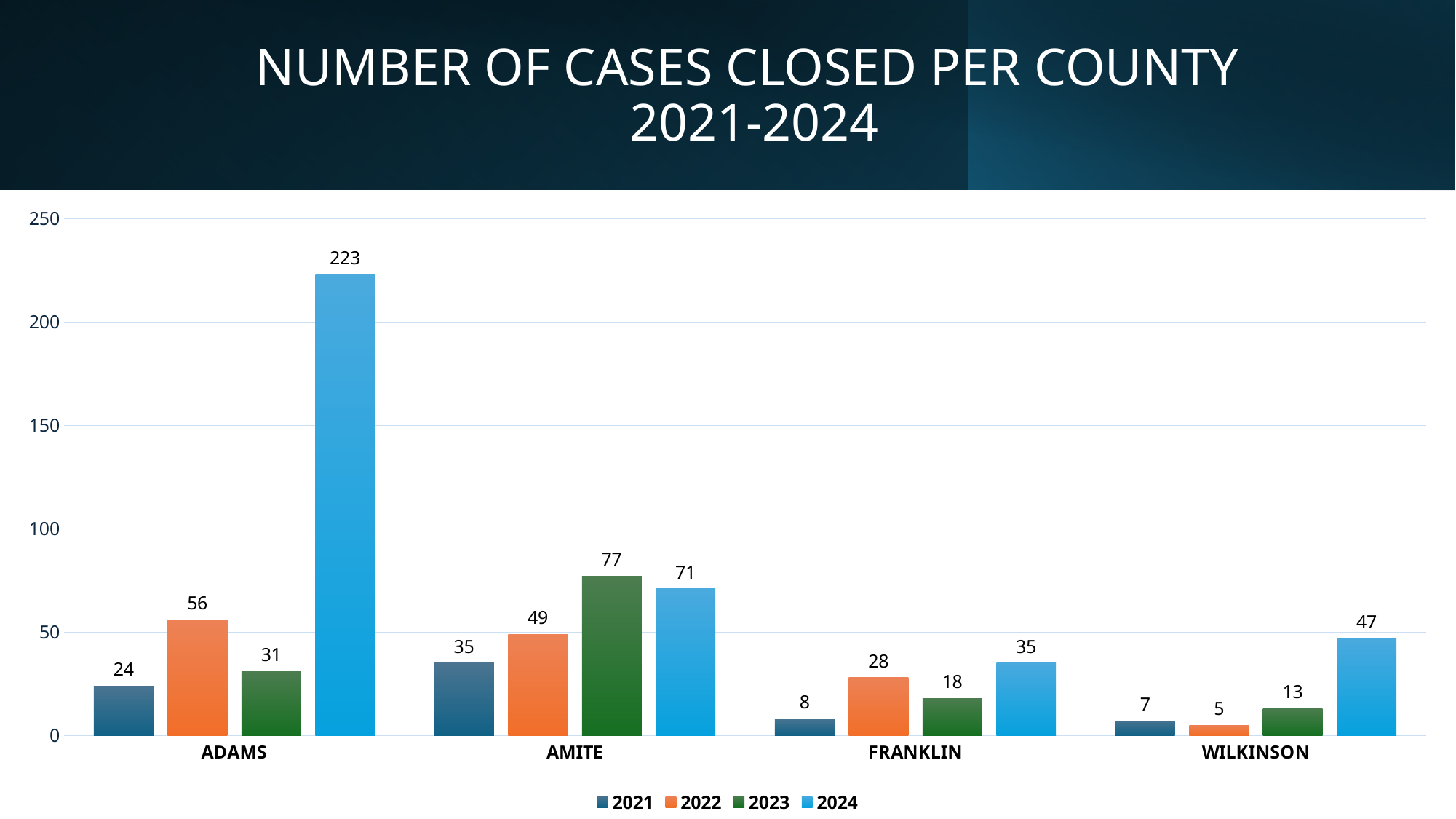
What is the difference between the 2024 and 2021 values for Franklin? 27 How many cases were closed in Wilkinson in 2022? 5 How many series does the legend list? 4 Which is larger: the 2023 value for Amite or the 2024 value for Amite? 2023 value for Amite How many cases were closed in Adams in 2024? 223 How many counties are shown on the x axis? 4 What is the title of the chart? NUMBER OF CASES CLOSED PER COUNTY 2021-2024 Which county had the lowest number of cases closed in 2021? Wilkinson Which county had the highest number of cases closed in 2024? Adams What kind of chart is shown on the slide? Bar chart Is the value for Adams in 2024 greater or less than 200? greater How many cases were closed in Amite in 2023? 77